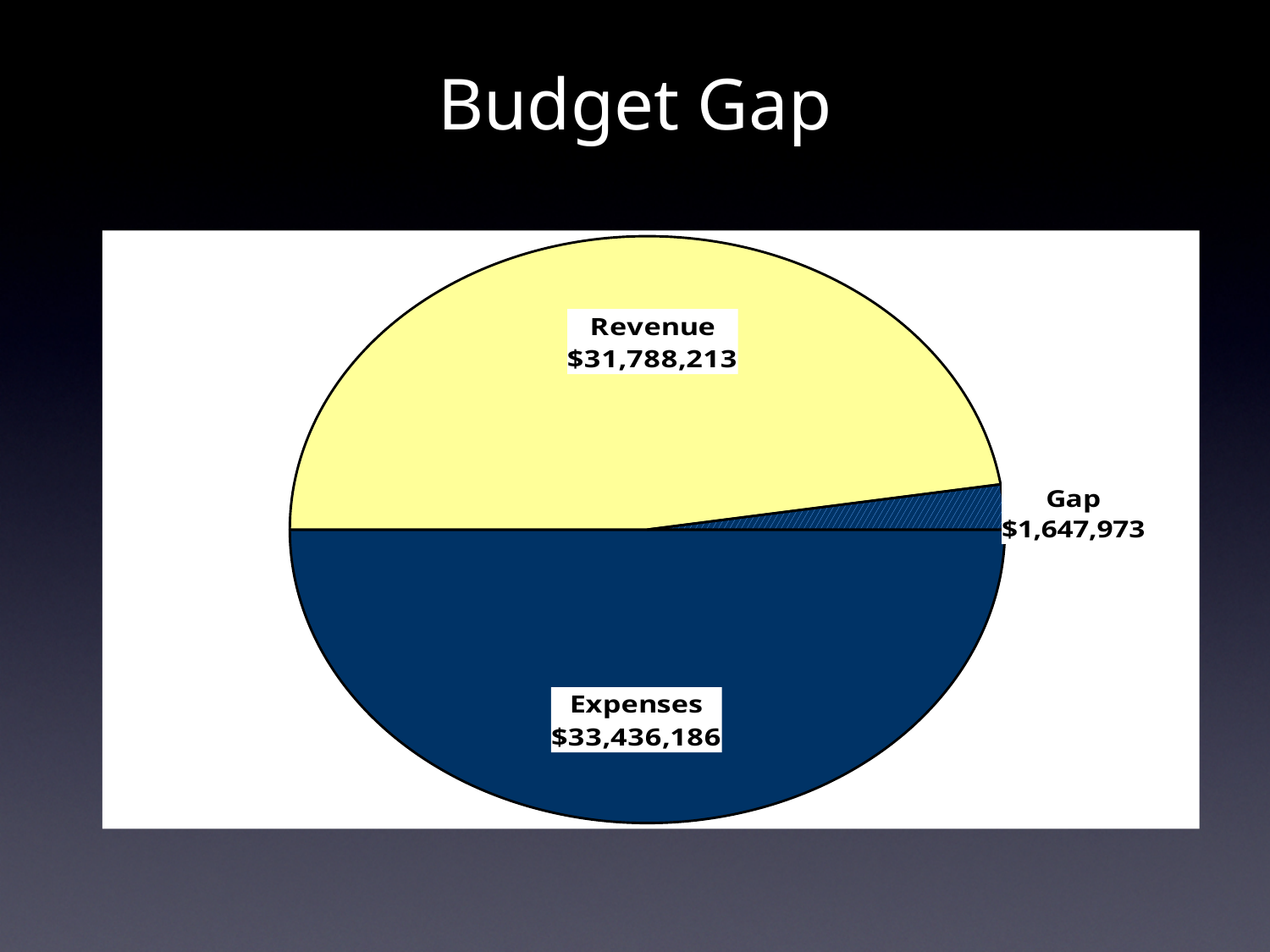
Which is larger, Revenue or Expenses? Expenses What is the value of the Revenue slice? $31,788,213 What is the value of the Expenses slice? $33,436,186 What is the difference between Expenses and Revenue? $1,647,973 Which slice of the pie is the smallest? Gap Which slice of the pie is the largest? Expenses What kind of chart is shown on the slide? Pie chart What is the value of the Gap slice? $1,647,973 What colour is the Revenue slice? Yellow How many slices does the pie chart have? 3 What is the title of the slide? Budget Gap What share of the pie does the Expenses slice represent? 50%